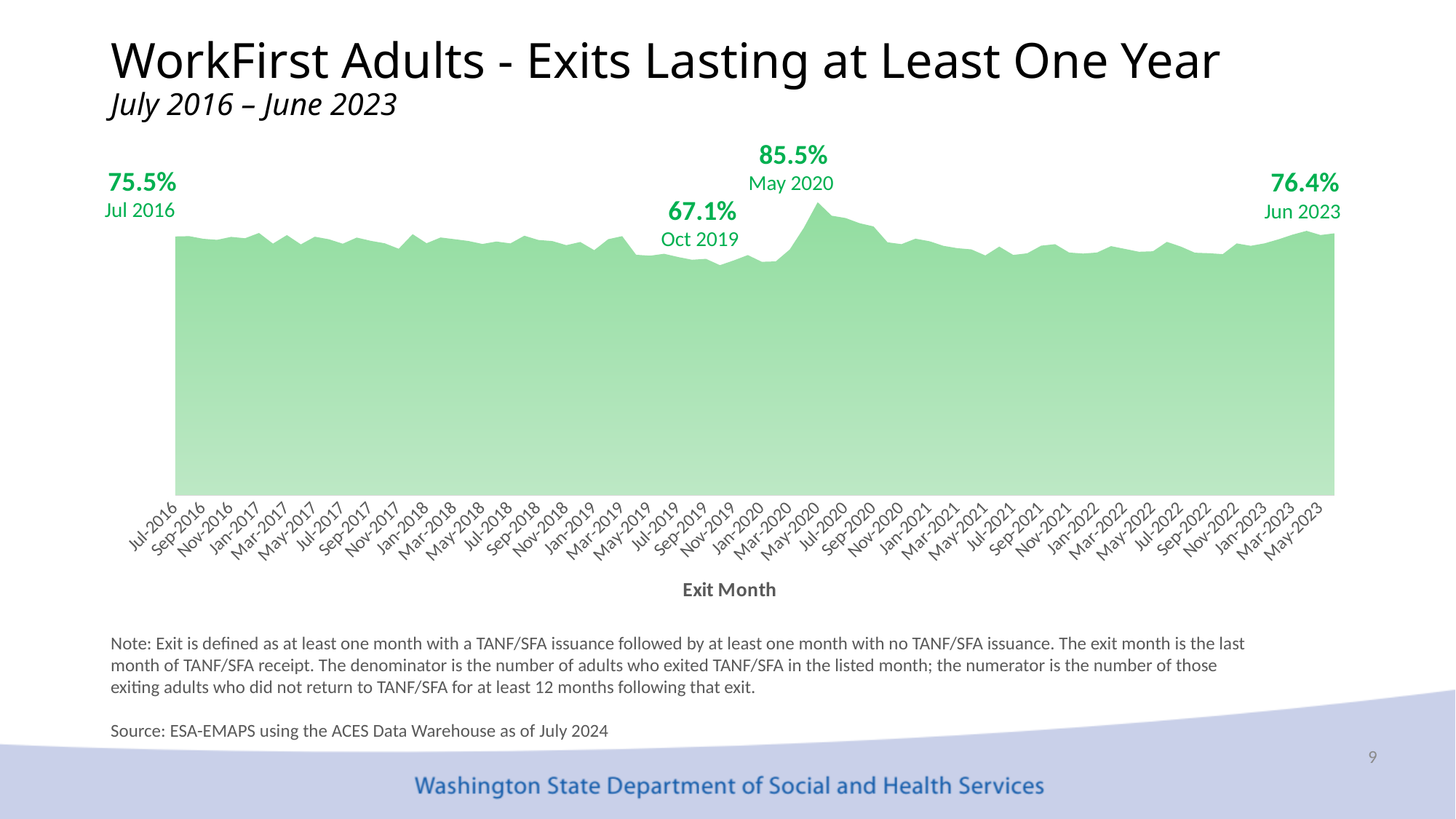
What is the value labeled for Jun 2023? 76.4% What is the value labeled for Oct 2019? 67.1% Which is larger, the value for Jul 2016 or the value for Jun 2023? Jun 2023 Which exit month has the highest value on the chart? May 2020 What is the title of the x axis? Exit Month What is the value labeled for May 2020? 85.5% Which exit month has the lowest value on the chart? Oct 2019 What is the difference between the Jun 2023 value and the Jul 2016 value? 0.9 percentage points Between Oct 2019 and May 2020, did the value rise or fall? rise What is the difference between the May 2020 value and the Oct 2019 value? 18.4 percentage points What kind of chart is shown on the slide? area chart What is the value labeled for Jul 2016? 75.5%